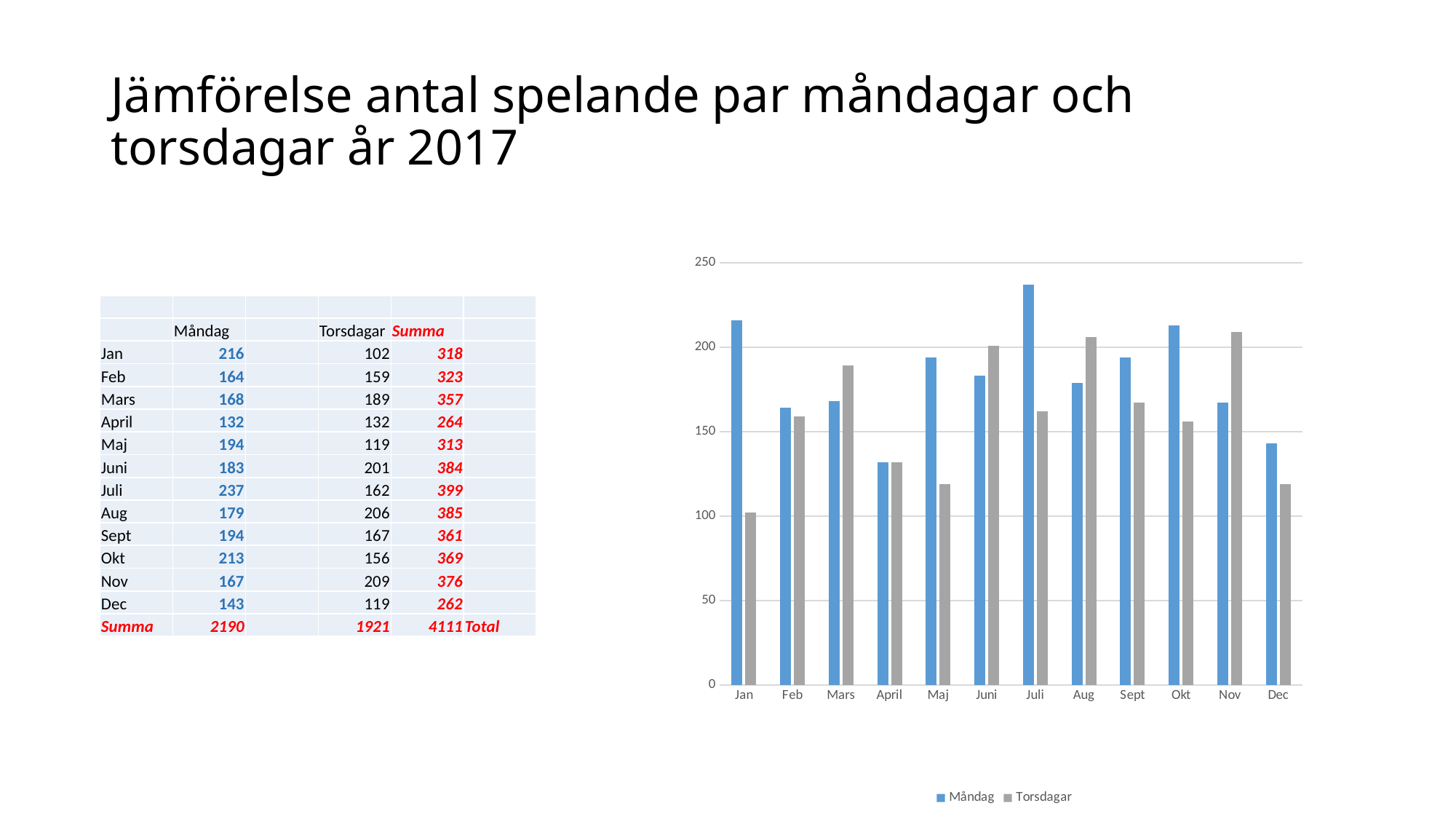
Which series is shown in blue in the chart? Måndag In Aug, which is larger, the Måndag bar or the Torsdagar bar? Torsdagar How many months are shown on the x axis of the chart? 12 What is the difference between the Måndag and Torsdagar values for Jan? 114 How many series does the chart legend list? 2 What is the Torsdagar value for Nov? 209 Which month has the lowest Torsdagar value in the chart? Jan What is the Måndag value for Juli? 237 What kind of chart is shown on the slide? bar chart Is the Måndag value for Okt greater or less than 200? greater Which month has the highest Måndag value in the chart? Juli Is the Torsdagar value for Jan greater or less than 150? less